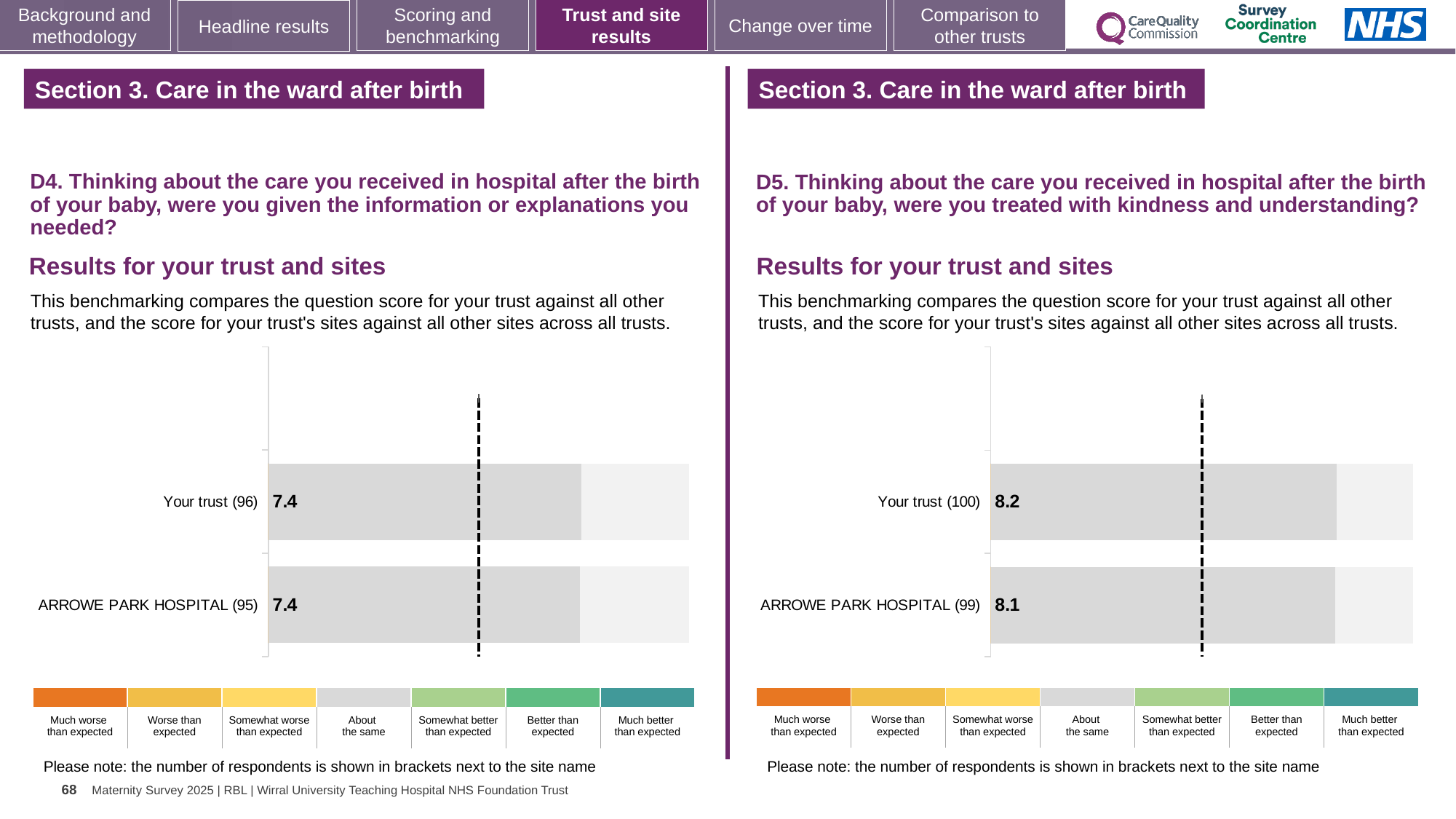
On the right chart (D5), what is the score for ARROWE PARK HOSPITAL? 8.1 On the left chart (D4), what is the difference between the score for Your trust and the score for ARROWE PARK HOSPITAL? 0 On the left chart (D4), how many respondents are shown in brackets for Your trust? 96 On the right chart (D5), what is the difference between the score for Your trust and the score for ARROWE PARK HOSPITAL? 0.1 How many bars are plotted on the left chart (D4)? 2 On the right chart (D5), what is the score for Your trust? 8.2 On the left chart (D4), what is the score for Your trust? 7.4 On the right chart (D5), which has the higher score, Your trust or ARROWE PARK HOSPITAL? Your trust What type of chart is used on the right (D5)? Bar chart On the right chart (D5), which category has the lowest score? ARROWE PARK HOSPITAL On the left chart (D4), what is the score for ARROWE PARK HOSPITAL? 7.4 On the right chart (D5), how many respondents are shown in brackets for ARROWE PARK HOSPITAL? 99